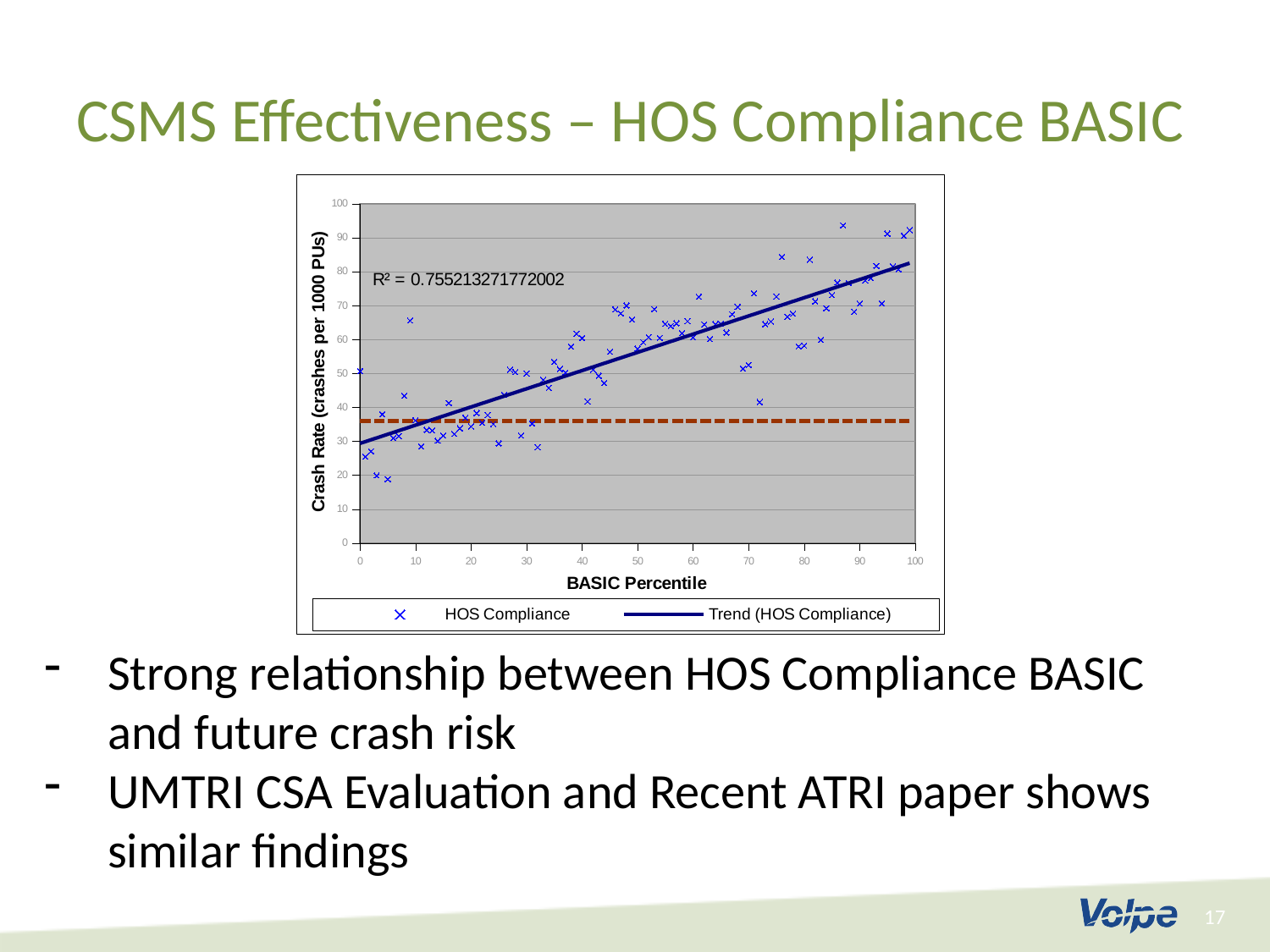
Do the crash rate values generally rise or fall as the BASIC Percentile increases? Rise What is the maximum value shown on the y axis of the chart? 100 Is the value of the trend line at BASIC Percentile 0 greater or less than 40? less How many series does the chart legend list? 2 Which series is drawn as a solid line in the chart? Trend (HOS Compliance) What kind of chart is shown on the slide? Scatter chart What R² value is printed on the chart? R² = 0.755213271772002 Is the value of the trend line at BASIC Percentile 100 greater or less than 70? greater What is the label of the x axis of the chart? BASIC Percentile Is the crash rate for the lowest plotted points (near BASIC Percentile 5) greater or less than 30? less What is the label of the y axis of the chart? Crash Rate (crashes per 1000 PUs)